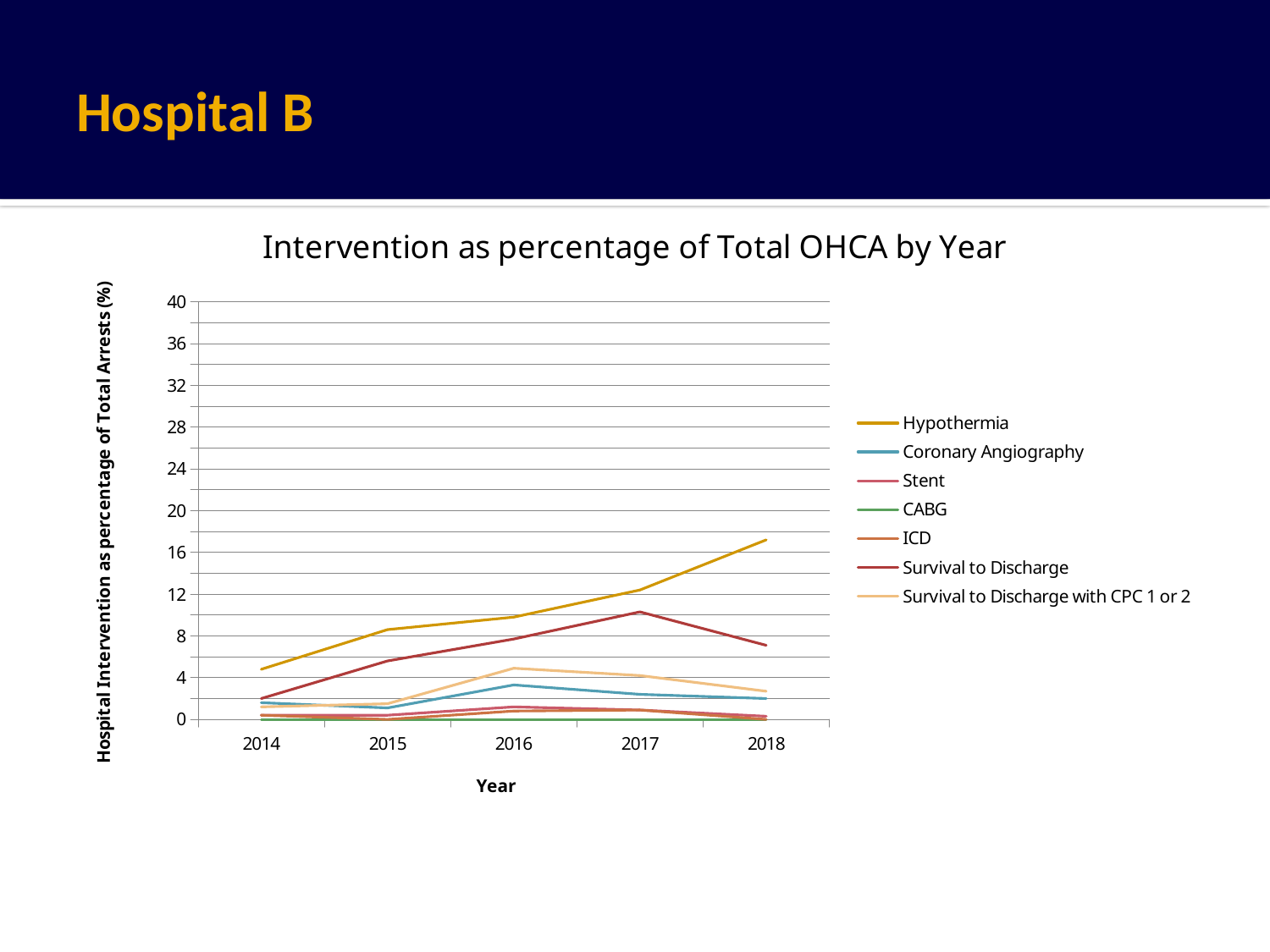
How many series does the legend list? 7 What is the title of the chart? Intervention as percentage of Total OHCA by Year What kind of chart is shown on the slide? line chart In which year is Hypothermia at its lowest? 2014 Is the value for Hypothermia in 2018 greater or less than 16? greater Is the value for Hypothermia in 2014 greater or less than 8? less How many years are shown on the x axis? 5 Is the value for Survival to Discharge in 2017 greater or less than 8? greater In which year is Survival to Discharge at its highest? 2017 In 2018, which is larger: Hypothermia or Survival to Discharge? Hypothermia Which series has the highest value in 2018? Hypothermia Does the Hypothermia line rise or fall from 2014 to 2018? rise